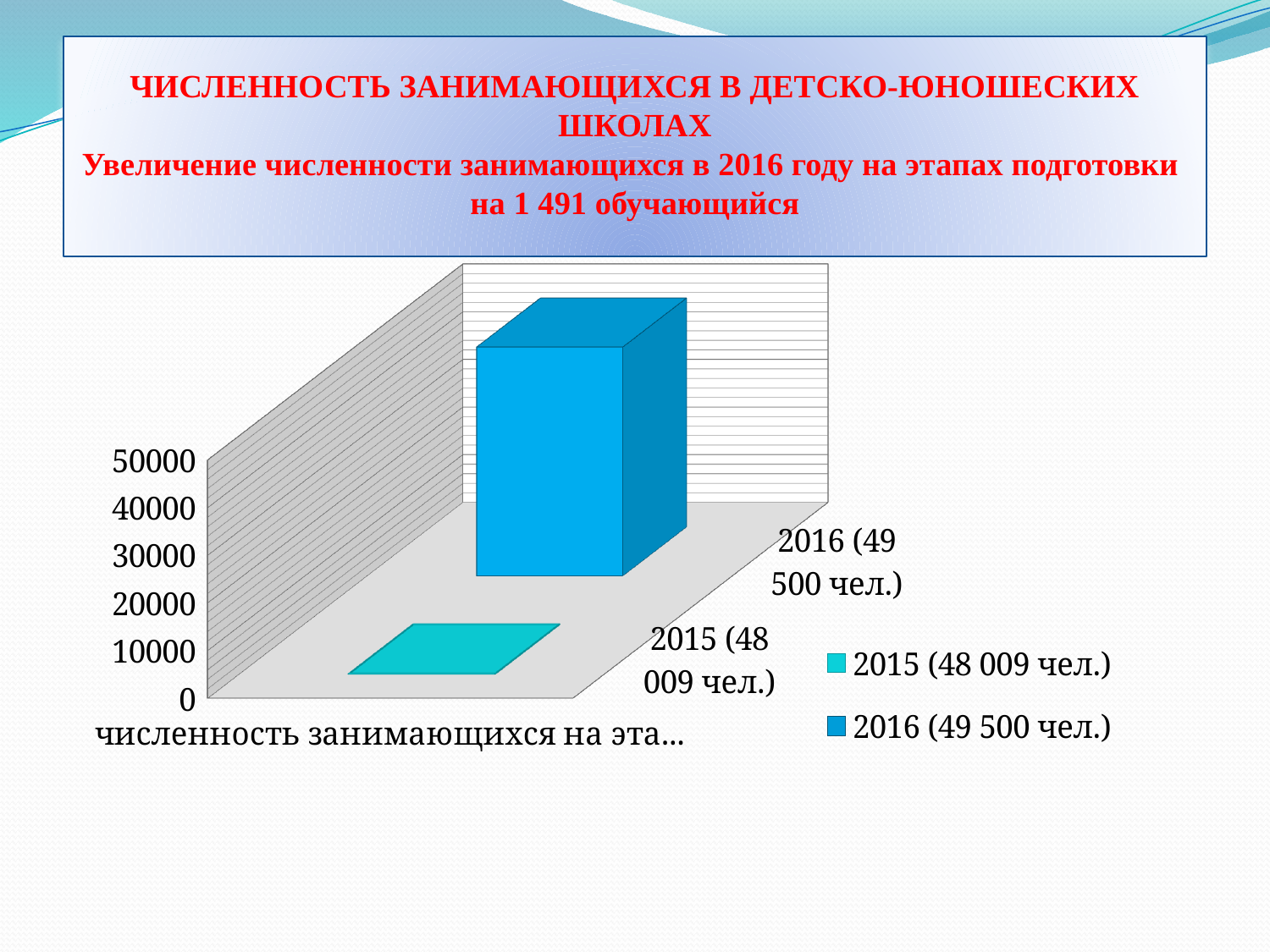
By how many students did enrolment increase in 2016, according to the slide? 1 491 What are the two series listed in the chart legend? 2015 (48 009 чел.) and 2016 (49 500 чел.) How many series does the chart legend list? 2 What kind of chart is shown on the slide? bar chart Is the value of the 2015 bar, as plotted, greater or less than 10000? less Which series has the taller bar, 2015 or 2016? 2016 According to the legend, how many people were enrolled in 2015? 48 009 чел. Is the value of the 2016 bar greater or less than 40000? greater According to the legend, how many people were enrolled in 2016? 49 500 чел. What is the highest tick value shown on the vertical axis? 50000 Which series is shown in the darker blue colour? 2016 (49 500 чел.)